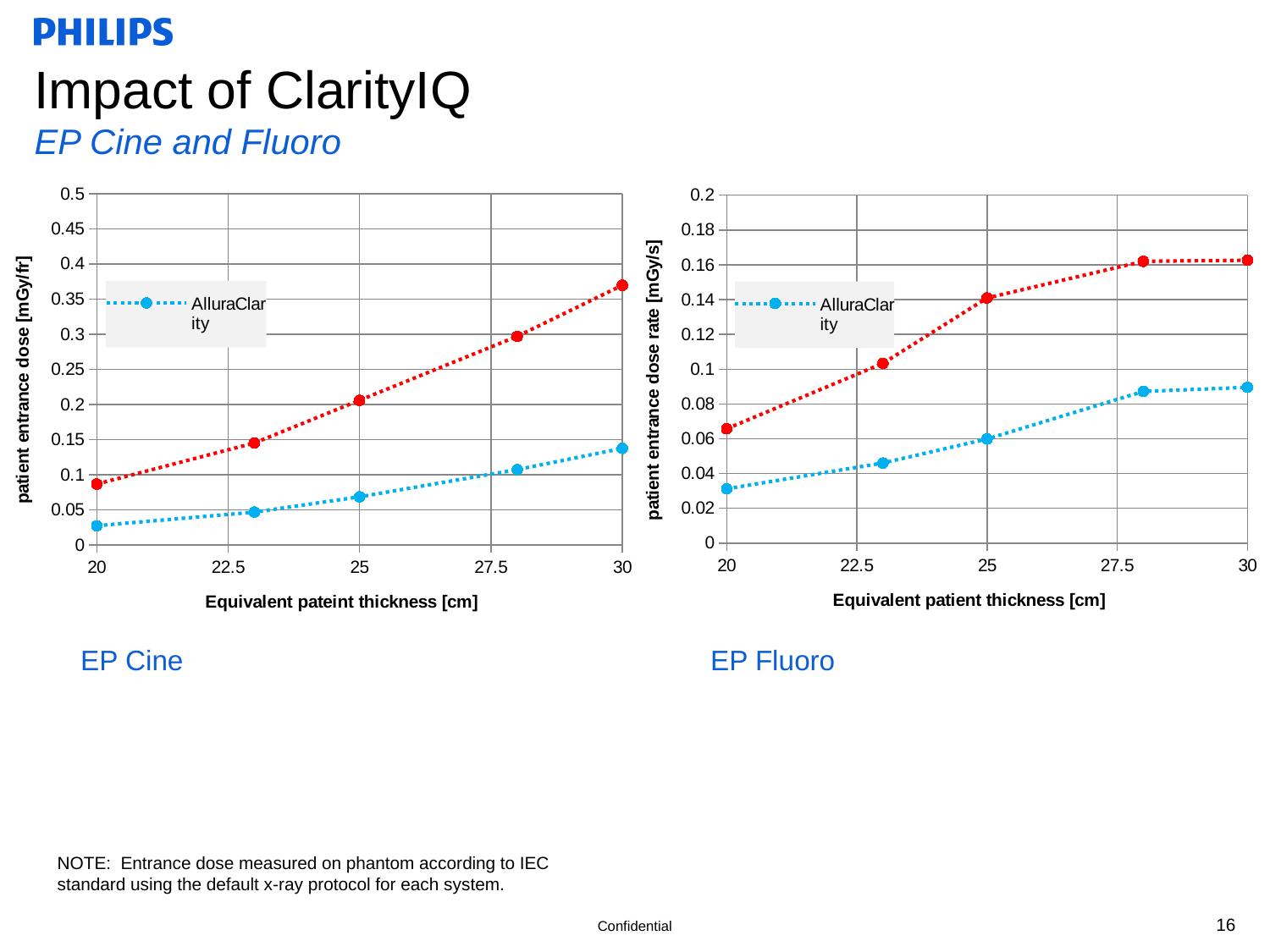
In the EP Fluoro chart, is the red series value at 30 cm greater or less than 0.14? greater In the EP Cine chart, is the AlluraClarity value at 30 cm greater or less than 0.1? greater How many series does the legend of the EP Fluoro chart list? 1 In the EP Cine chart, which series has the higher value at 30 cm, the red series or AlluraClarity? the red series In the EP Cine chart, is the red series value at 30 cm greater or less than 0.35? greater What is the y-axis label of the EP Fluoro chart? patient entrance dose rate [mGy/s] What type of chart is the EP Cine chart on the left? line chart In the EP Cine chart, does the AlluraClarity patient entrance dose rise or fall as equivalent patient thickness increases from 20 to 30 cm? rise In the EP Cine chart, how many data points does the AlluraClarity series have? 5